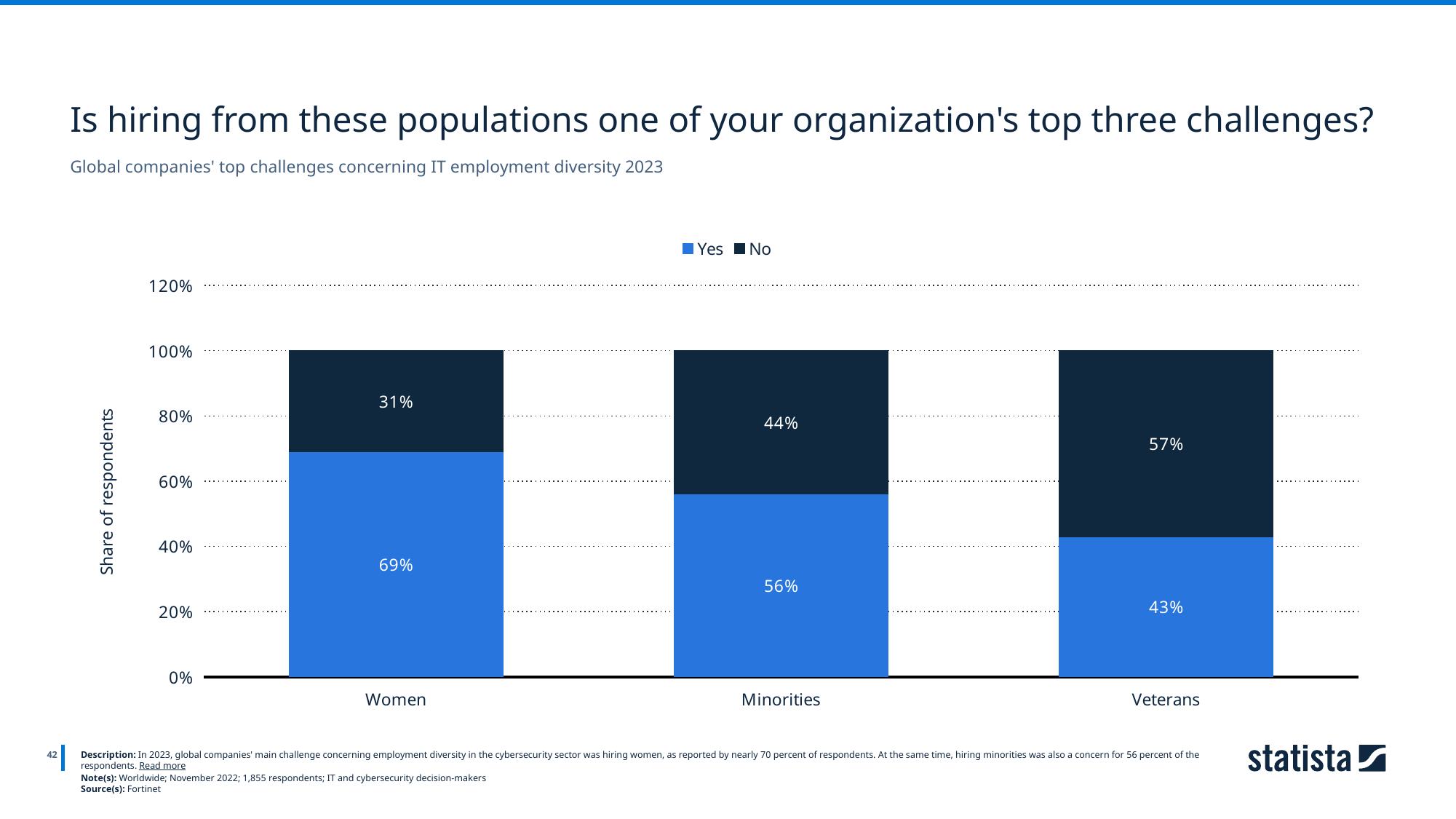
What is the label of the y axis? Share of respondents How many series does the legend list? 2 Which is larger: the No share for Veterans or the No share for Women? No share for Veterans What share of respondents answered Yes for Veterans? 43% Which population has the highest Yes share? Women What is the total of the stacked bar for Minorities? 100% What kind of chart is shown on the slide? Stacked bar chart Which population has the lowest Yes share? Veterans What share of respondents answered No for Minorities? 44% What is the difference between the Yes share for Women and the Yes share for Minorities? 13% What share of respondents answered Yes for Women? 69% How many populations are shown on the x axis? 3